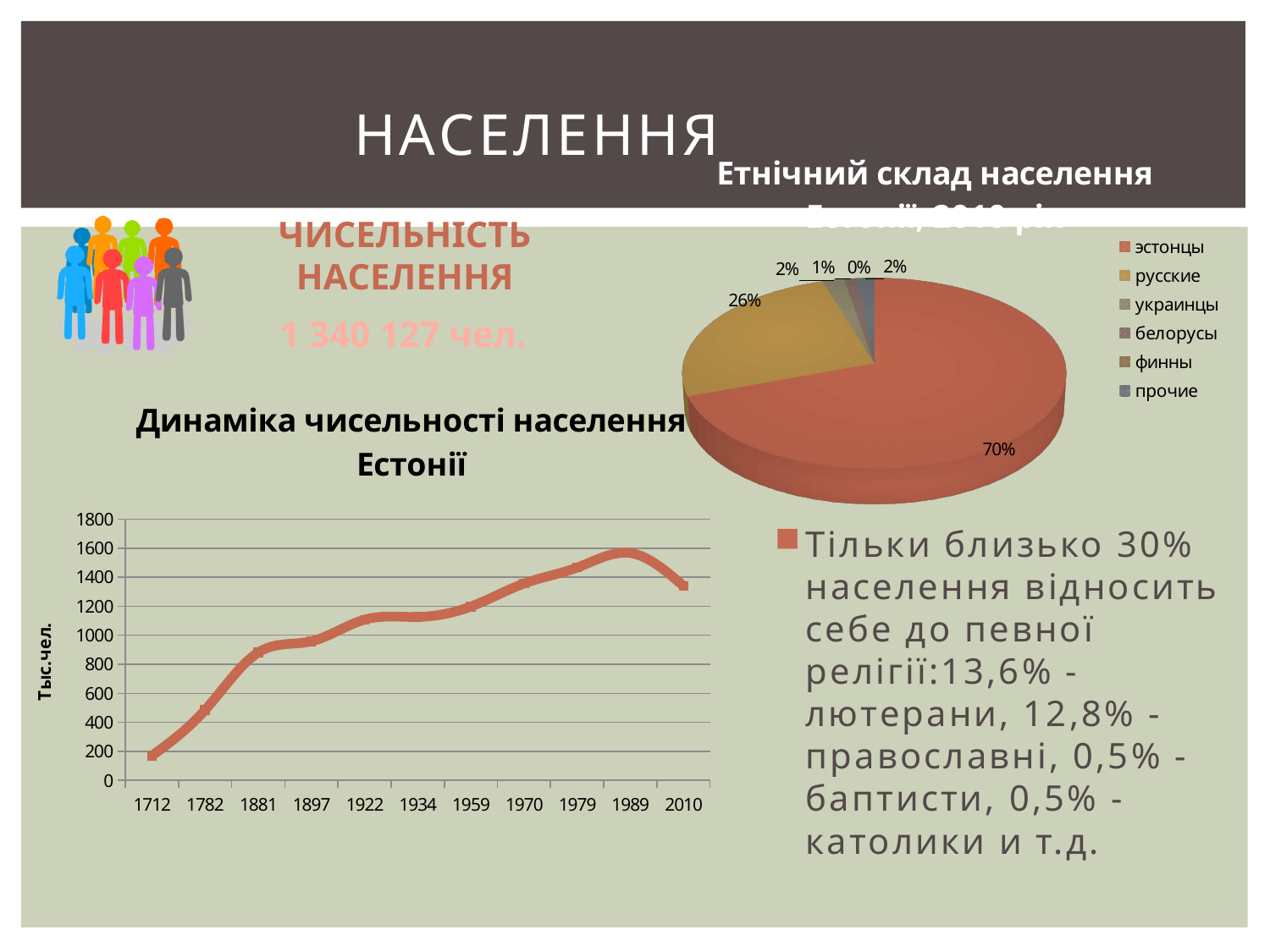
What kind of chart is the chart titled 'Динаміка чисельності населення Естонії'? line chart In the chart 'Динаміка чисельності населення Естонії', which year has the lowest value? 1712 In the chart 'Динаміка чисельності населення Естонії', which year has the highest value? 1989 In the pie chart on the right of the slide, what share is labelled for русские? 26% In the chart 'Динаміка чисельності населення Естонії', is the value for 2010 greater or less than 1200? greater In the chart 'Динаміка чисельності населення Естонії', does the value rise or fall between 1989 and 2010? fall In the chart 'Динаміка чисельності населення Естонії', what is the y-axis label? Тыс.чел. How many entries does the legend of the pie chart on the right of the slide list? 6 In the chart 'Динаміка чисельності населення Естонії', how many years are shown on the x axis? 11 In the pie chart on the right of the slide, what share is labelled for эстонцы? 70% In the chart 'Динаміка чисельності населення Естонії', is the value for 1881 greater or less than 800? greater In the chart 'Динаміка чисельності населення Естонії', is the value for 1712 greater or less than 400? less